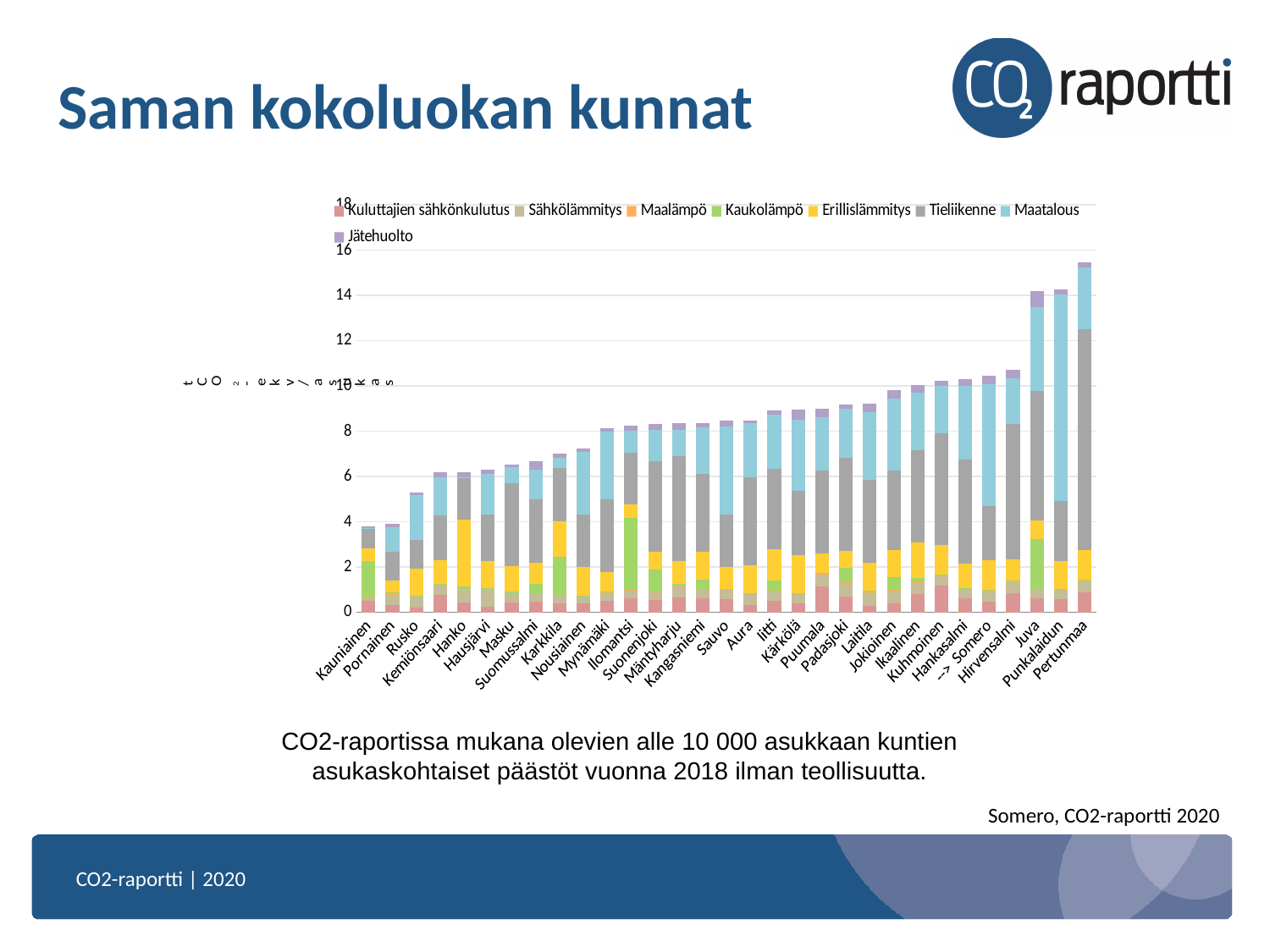
Which municipality has the highest total bar? Pertunmaa Do the total bar heights generally rise or fall from left to right along the x axis? rise What kind of chart is shown on the slide? stacked bar chart Is the total value for Juva greater or less than 12? greater How many municipalities (categories) are shown on the x axis? 31 Which municipality has the lowest total bar? Kauniainen Is the total value for Pertunmaa greater or less than 14? greater Which legend entry is shown in light blue? Maatalous How many series does the legend list? 8 Which has the larger total bar, Juva or Rusko? Juva Is the total value for Hirvensalmi greater or less than 10? greater